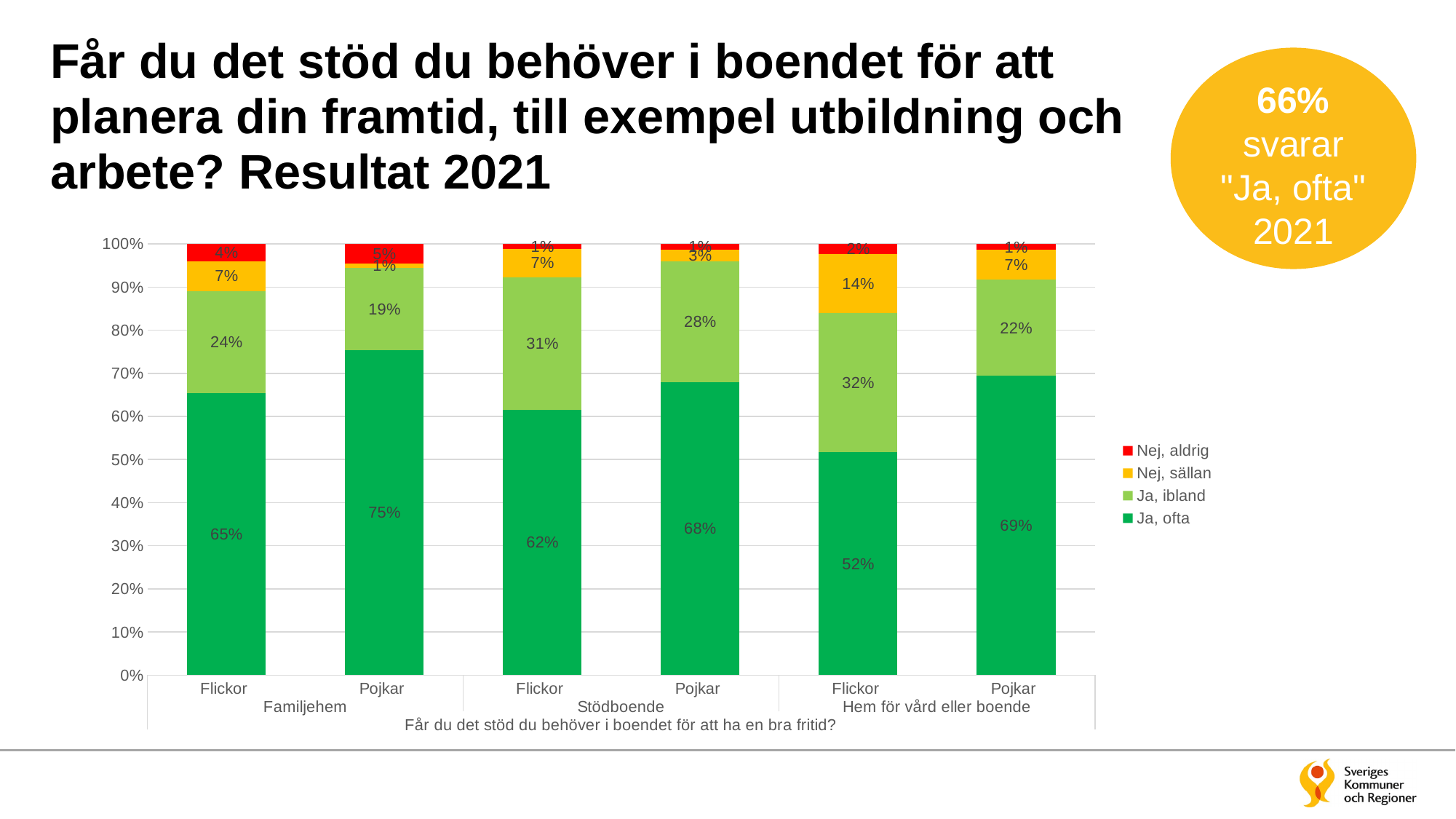
What is the difference in the "Ja, ofta" share between Pojkar and Flickor in Hem för vård eller boende? 17 percentage points Who has a larger "Ja, ibland" share in Stödboende, Flickor or Pojkar? Flickor What percentage of Pojkar in Familjehem answered "Ja, ofta"? 75% What percentage of Flickor in Hem för vård eller boende answered "Nej, sällan"? 14% What percentage of Flickor in Familjehem answered "Ja, ofta"? 65% Which group has the lowest share answering "Ja, ofta"? Flickor, Hem för vård eller boende What percentage of Flickor in Stödboende answered "Ja, ibland"? 31% How many bars are shown in the chart? 6 What type of chart is shown on the slide? Stacked bar chart Which group has the highest share answering "Ja, ofta"? Pojkar, Familjehem Which colour represents "Nej, aldrig" in the chart? Red How many series does the legend list? 4